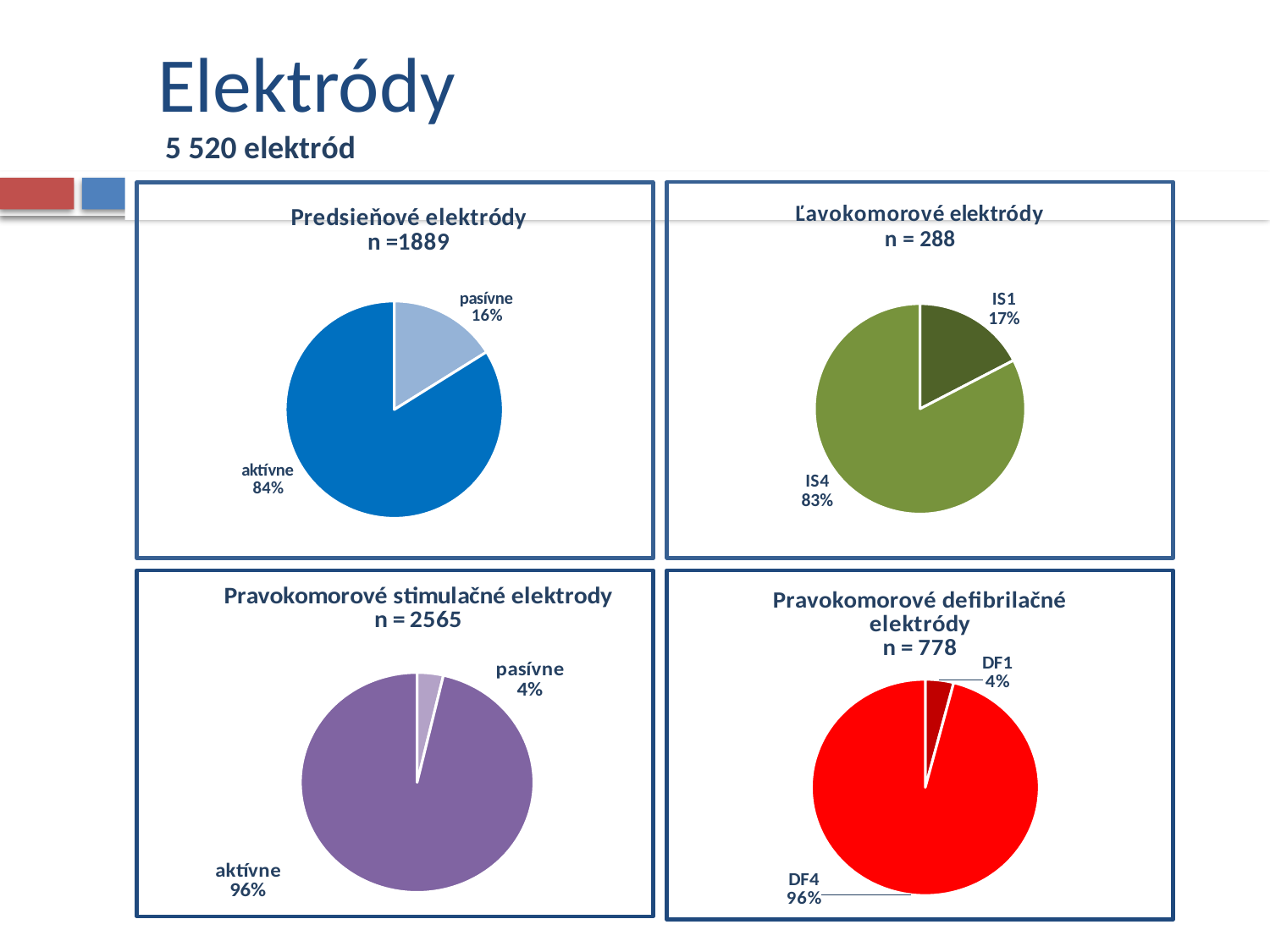
In the 'Predsieňové elektródy' chart, what share of the pie is 'aktívne'? 84% In the 'Ľavokomorové elektródy' chart, which category is the largest? IS4 In the 'Pravokomorové stimulačné elektrody' chart, what is the value for 'pasívne'? 4% In the 'Predsieňové elektródy' chart, what is the value for 'pasívne'? 16% In the 'Pravokomorové defibrilačné elektródy' chart, which category is the smallest? DF1 Which is larger in the 'Ľavokomorové elektródy' chart, 'IS1' or 'IS4'? IS4 In the 'Pravokomorové defibrilačné elektródy' chart, what is the value for 'DF4'? 96% How many categories does the 'Predsieňové elektródy' chart show? 2 What kind of chart is the 'Ľavokomorové elektródy' chart? Pie chart What is the n value shown in the title of the 'Pravokomorové defibrilačné elektródy' chart? n = 778 In the 'Pravokomorové stimulačné elektrody' chart, what is the difference between 'aktívne' and 'pasívne'? 92% In the 'Ľavokomorové elektródy' chart, what is the value for 'IS1'? 17%